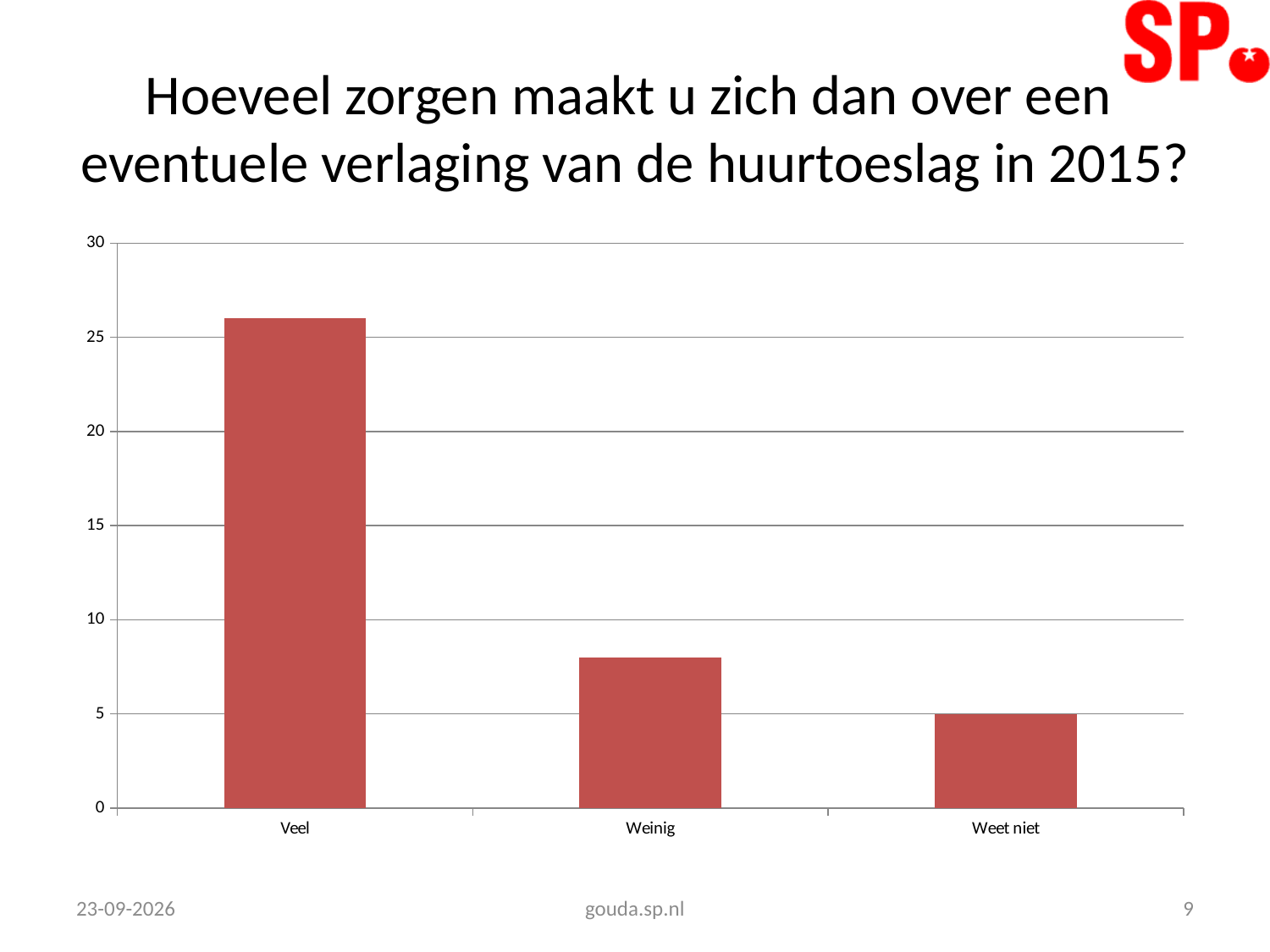
Is the value for Veel greater or less than 25? greater Is the value for Weinig greater or less than 5? greater Which is larger, the value for Weinig or the value for Weet niet? Weinig Is the value for Veel greater or less than 20? greater What kind of chart is shown on the slide? bar chart Do the bar values rise or fall from left to right along the x axis? fall Which category has the highest bar? Veel How many categories are shown on the x axis of the chart? 3 Which category has the lowest bar? Weet niet What is the highest value shown on the y axis? 30 What is the value for Weet niet? 5